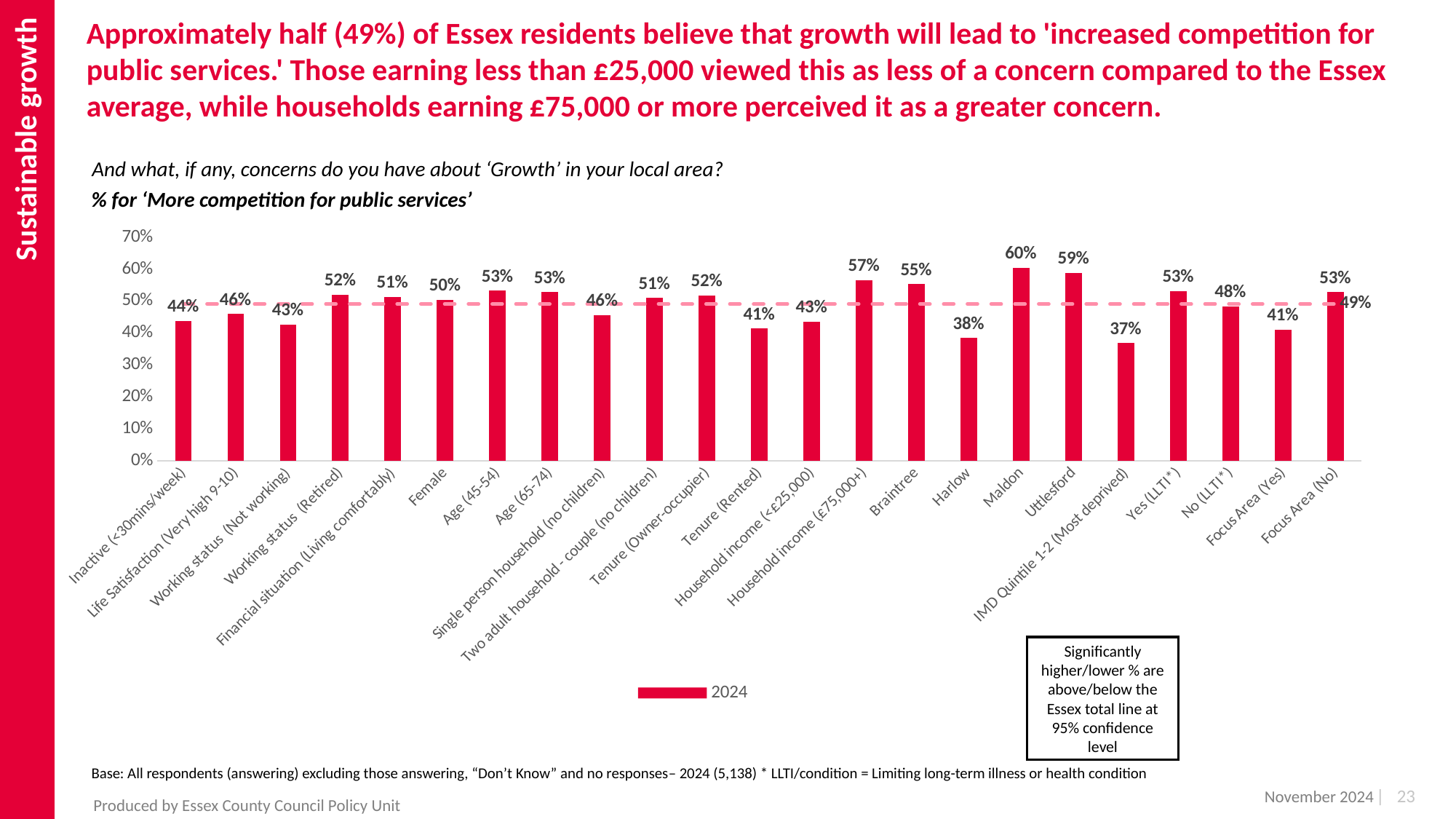
How many series does the legend list? 1 How many bars are plotted in the chart? 23 What is the value for Tenure (Rented)? 41% What value does the dashed horizontal line (Essex total) represent? 49% What is the value for Maldon? 60% Which category has the lowest value? IMD Quintile 1-2 (Most deprived) What kind of chart is shown on the slide? Bar chart Which is larger, the value for Harlow or the value for Braintree? Braintree Is the value for Uttlesford greater or less than 50%? greater What is the value for Household income (£75,000+)? 57% Which category has the highest value? Maldon What is the difference between the values for Household income (£75,000+) and Household income (<£25,000)? 14 percentage points